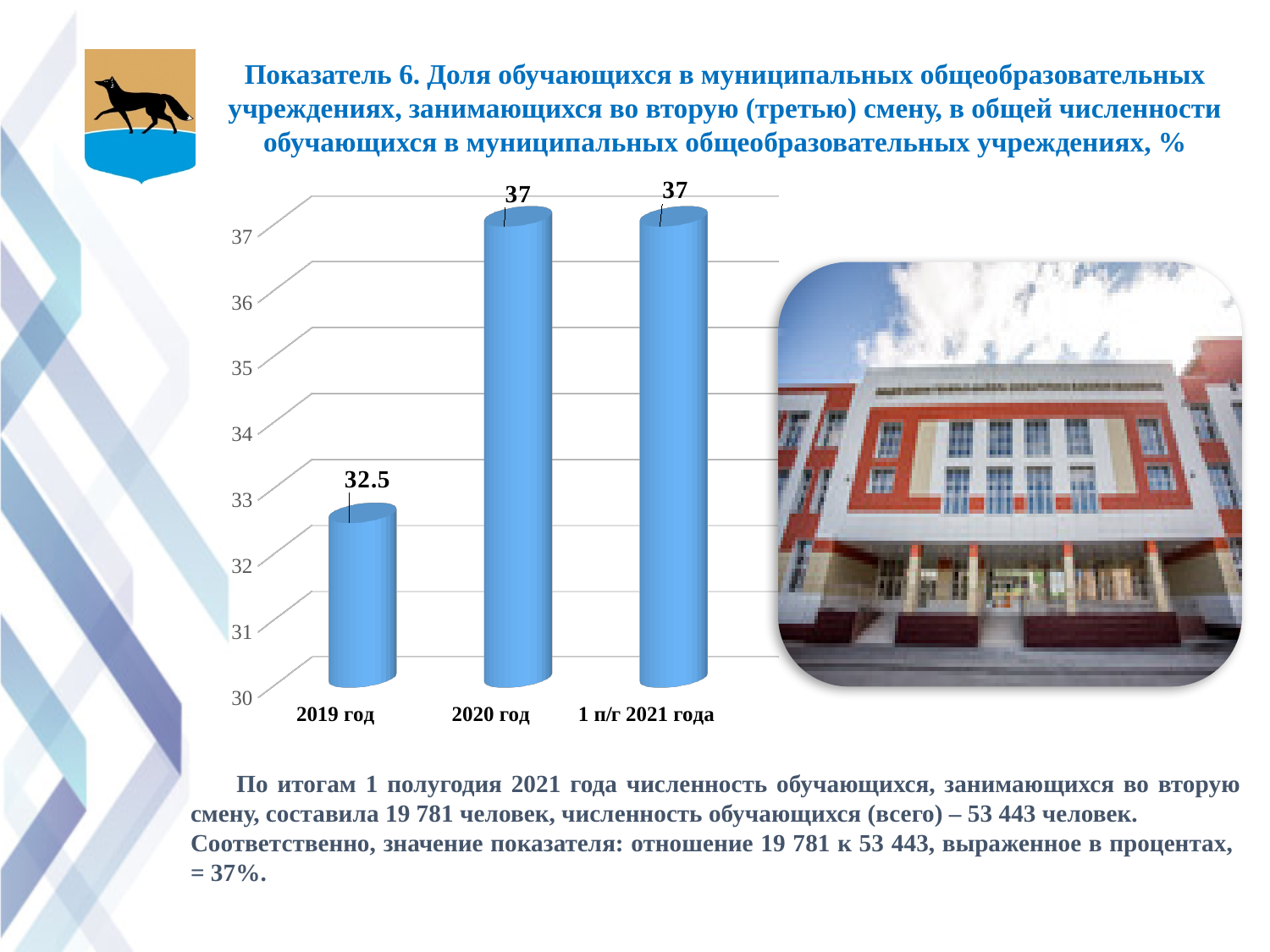
What is the difference between the values for 2020 год and 2019 год? 4.5 What kind of chart is shown on the slide? bar chart Which is larger, the value for 2019 год or the value for 2020 год? 2020 год Do the values rise or fall from 2019 год to 2020 год? rise What is the value for 2019 год? 32.5 How many categories are shown on the x axis? 3 Which category has the lowest value? 2019 год What is the value for 2020 год? 37 What is the value for 1 п/г 2021 года? 37 Is the value for 2020 год greater or less than 35? greater Is the value for 2019 год greater or less than 33? less What colour are the bars in the chart? blue